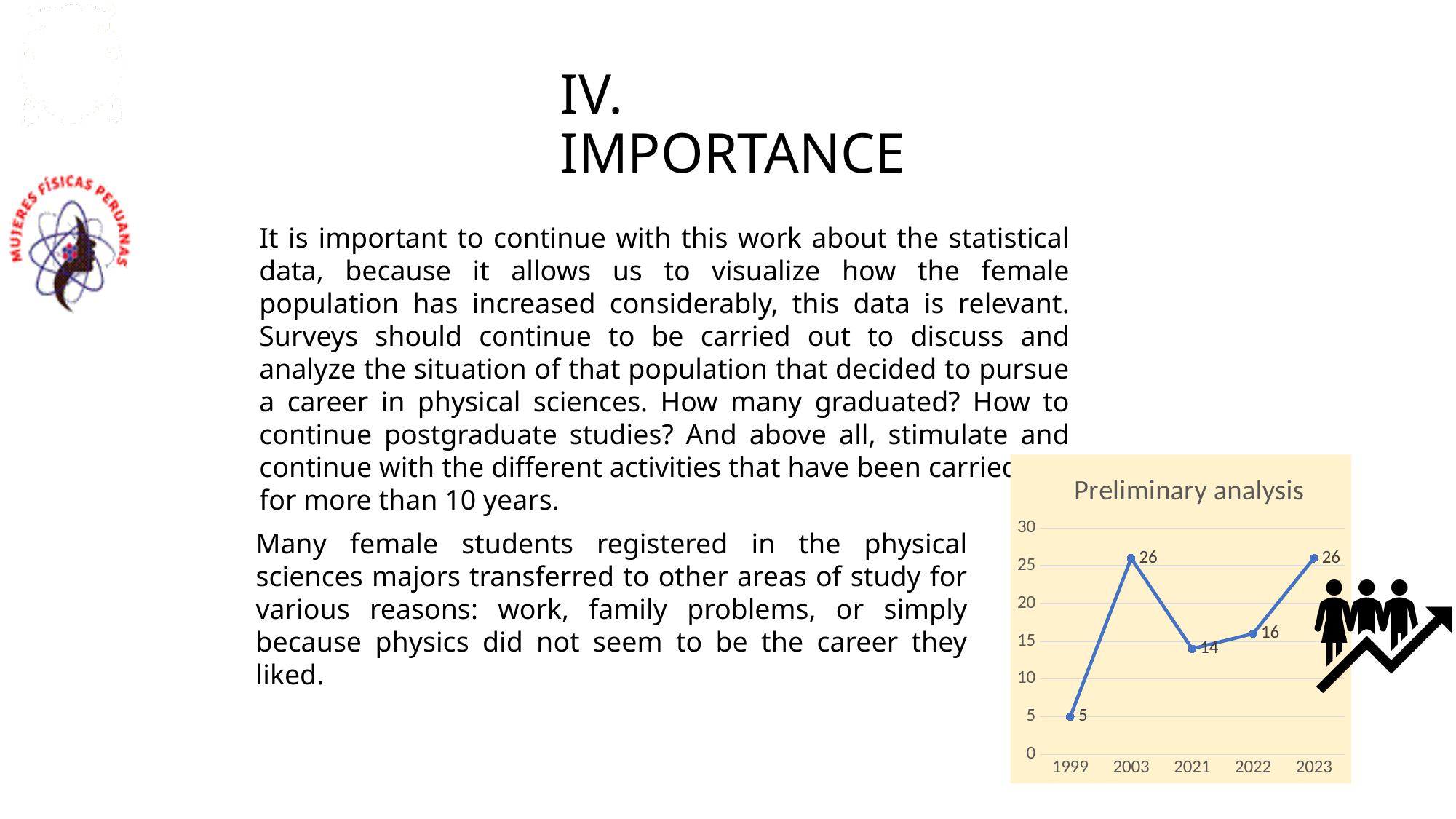
What is the difference between the values for 2022 and 1999 in the Preliminary analysis chart? 11 Which is larger in the Preliminary analysis chart, the value for 2022 or the value for 2021? 2022 What kind of chart is the Preliminary analysis chart? line chart What is the difference between the values for 2003 and 2021 in the Preliminary analysis chart? 12 What is the value for 1999 in the Preliminary analysis chart? 5 Which year has the lowest value in the Preliminary analysis chart? 1999 In the Preliminary analysis chart, does the value rise or fall from 2021 to 2023? rise What is the value for 2003 in the Preliminary analysis chart? 26 What is the title of the chart on the slide? Preliminary analysis How many data points are plotted in the Preliminary analysis chart? 5 What is the value for 2021 in the Preliminary analysis chart? 14 What is the value for 2022 in the Preliminary analysis chart? 16